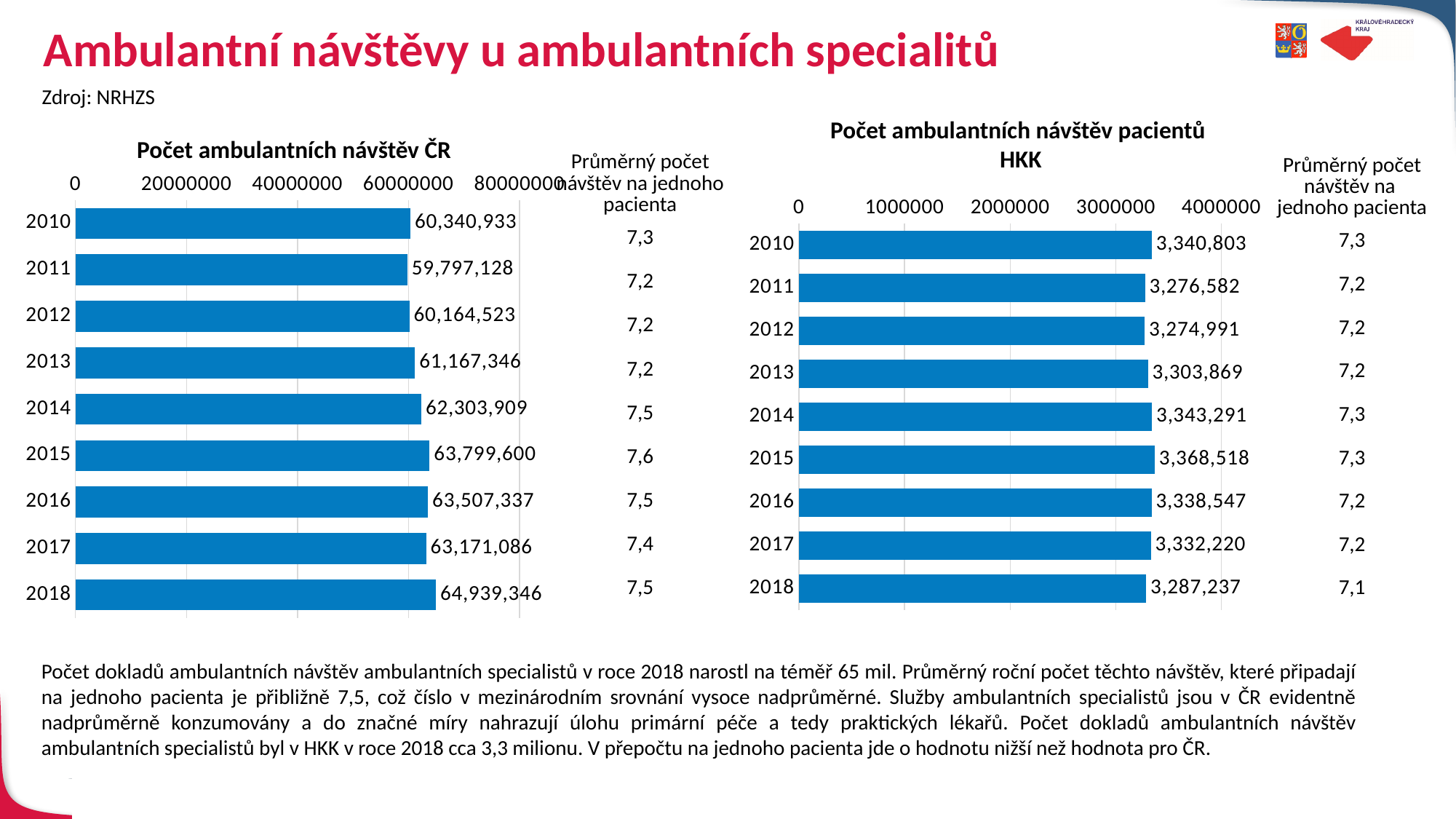
In the chart 'Počet ambulantních návštěv pacientů HKK', which year has the highest value? 2015 In the chart 'Počet ambulantních návštěv pacientů HKK', what is the value for 2015? 3,368,518 In the chart 'Počet ambulantních návštěv ČR', which is larger, the value for 2015 or the value for 2016? 2015 In the chart 'Počet ambulantních návštěv ČR', what is the value for 2018? 64,939,346 In the chart 'Počet ambulantních návštěv ČR', what is the value for 2011? 59,797,128 In the chart 'Počet ambulantních návštěv ČR', which year has the lowest value? 2011 In the chart 'Počet ambulantních návštěv pacientů HKK', what is the value for 2018? 3,287,237 In the chart 'Počet ambulantních návštěv ČR', which year has the highest value? 2018 How many years are shown in the chart 'Počet ambulantních návštěv pacientů HKK'? 9 In the chart 'Počet ambulantních návštěv pacientů HKK', what is the difference between the values for 2015 and 2018? 81,281 In the chart 'Počet ambulantních návštěv ČR', what is the difference between the values for 2018 and 2010? 4,598,413 What kind of chart is 'Počet ambulantních návštěv ČR'? bar chart